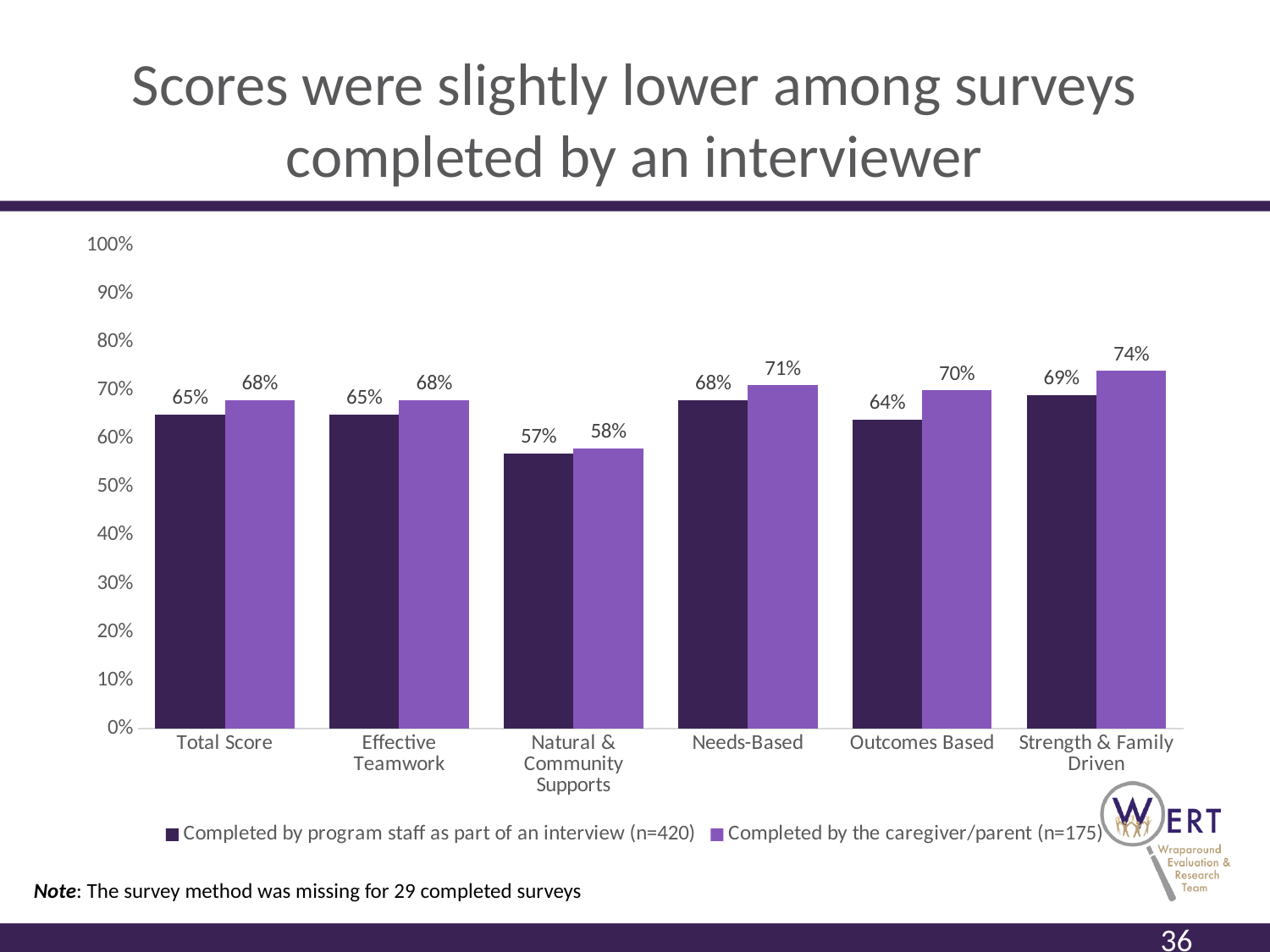
Which category has the lowest value in the 'Completed by program staff as part of an interview (n=420)' series? Natural & Community Supports What is the value for Natural & Community Supports in the 'Completed by program staff as part of an interview (n=420)' series? 57% How many series does the legend list? 2 Is the value for Natural & Community Supports in the caregiver/parent series greater or less than 60%? less How many categories are shown on the x axis? 6 What is the value for Outcomes Based in the 'Completed by program staff as part of an interview (n=420)' series? 64% What is the sample size (n) for the 'Completed by program staff as part of an interview' series shown in the legend? 420 For Needs-Based, which series has the larger value: program staff interview or caregiver/parent? Completed by the caregiver/parent (n=175) What is the value for Strength & Family Driven in the 'Completed by the caregiver/parent (n=175)' series? 74% What kind of chart is shown on the slide? bar chart What is the difference between the caregiver/parent value and the program staff value for Outcomes Based? 6% Which category has the highest value in the 'Completed by the caregiver/parent (n=175)' series? Strength & Family Driven